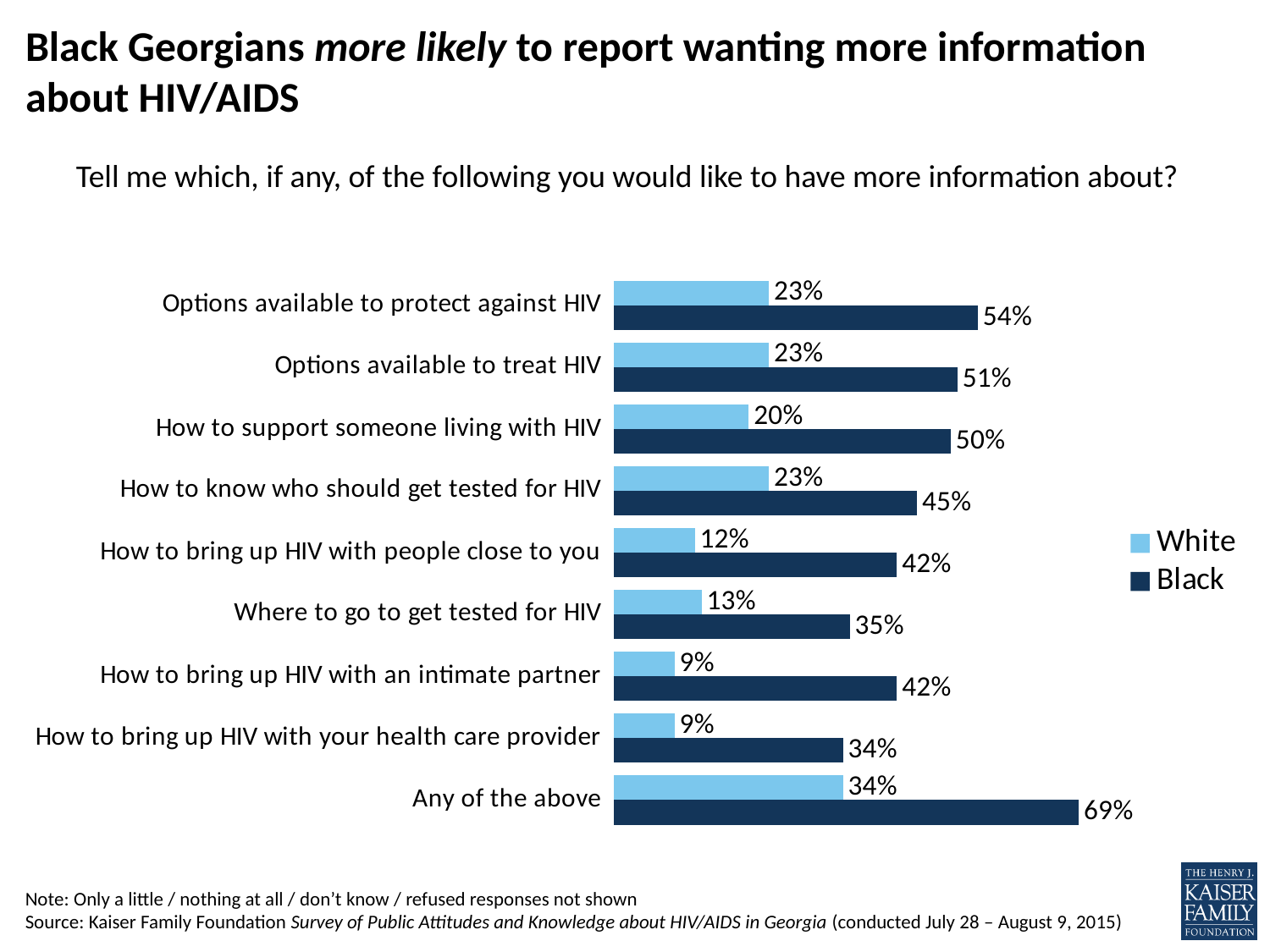
How many series does the legend list? 2 How many categories are shown on the chart? 9 What percentage of Black respondents said they would like more information about options available to protect against HIV? 54% Which category has the lowest value for Black respondents? How to bring up HIV with your health care provider What kind of chart is shown on the slide? Bar chart What is the difference between the Black and White values for 'Options available to treat HIV'? 28 percentage points Which is larger: the White value for 'Where to go to get tested for HIV' or the White value for 'How to bring up HIV with people close to you'? Where to go to get tested for HIV What percentage of Black respondents selected 'Any of the above'? 69% What is the difference between the Black and White values for 'Any of the above'? 35 percentage points Which series is shown in dark blue in the legend? Black What percentage of White respondents said they would like more information about how to bring up HIV with an intimate partner? 9% Which category has the highest value for Black respondents? Any of the above